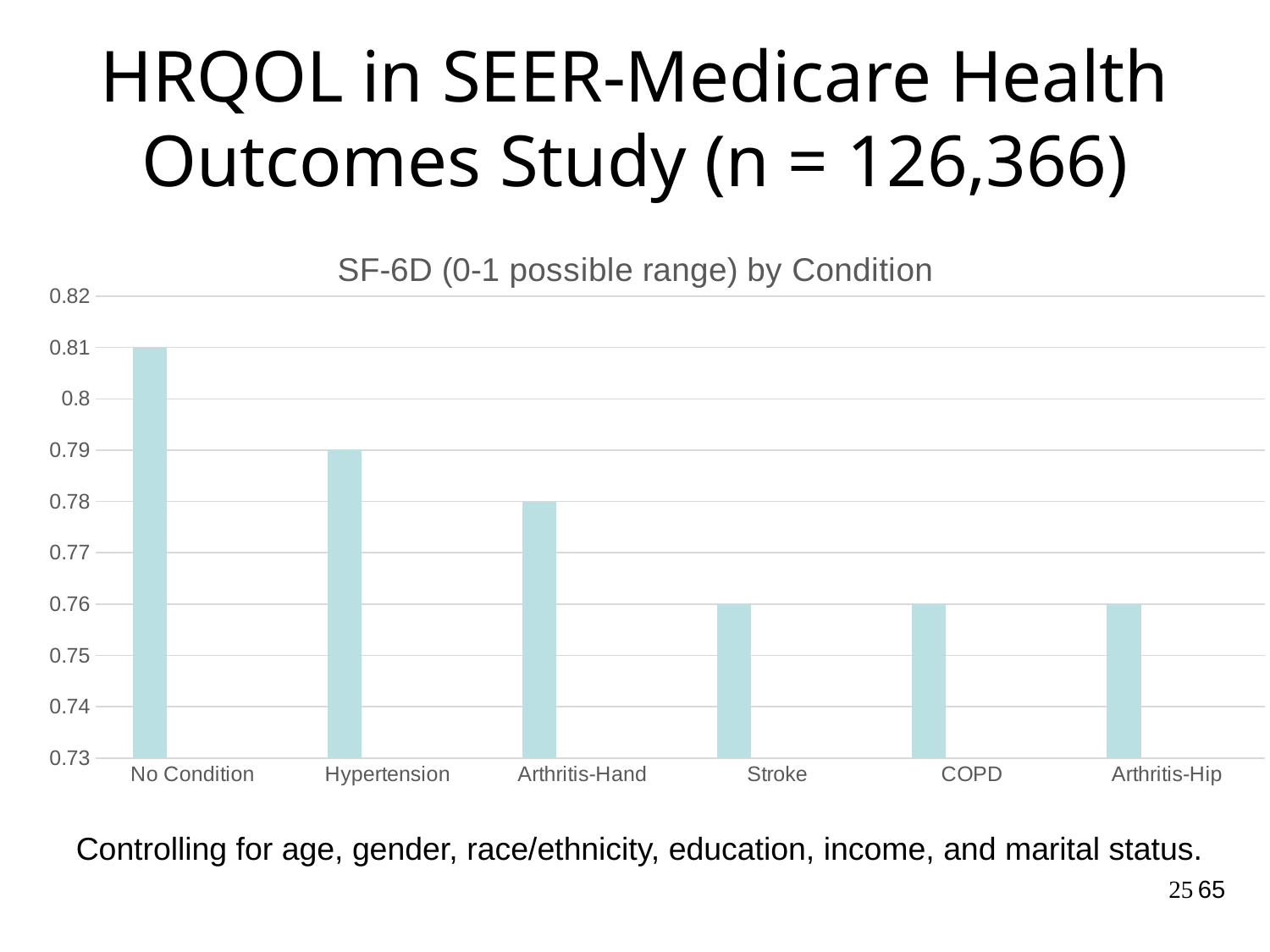
Which condition has the highest SF-6D value? No Condition What is the title of the chart? SF-6D (0-1 possible range) by Condition How many conditions are shown on the x axis? 6 What is the SF-6D value for Arthritis-Hand? 0.78 What kind of chart is shown on the slide? bar chart What is the SF-6D value for No Condition? 0.81 Which has a larger SF-6D value, Hypertension or Arthritis-Hand? Hypertension What is the SF-6D value for Hypertension? 0.79 Do the SF-6D values rise or fall from left to right across the conditions? fall What is the SF-6D value for Stroke? 0.76 Is the SF-6D value for COPD greater or less than 0.78? less What is the difference between the SF-6D values for No Condition and Hypertension? 0.02